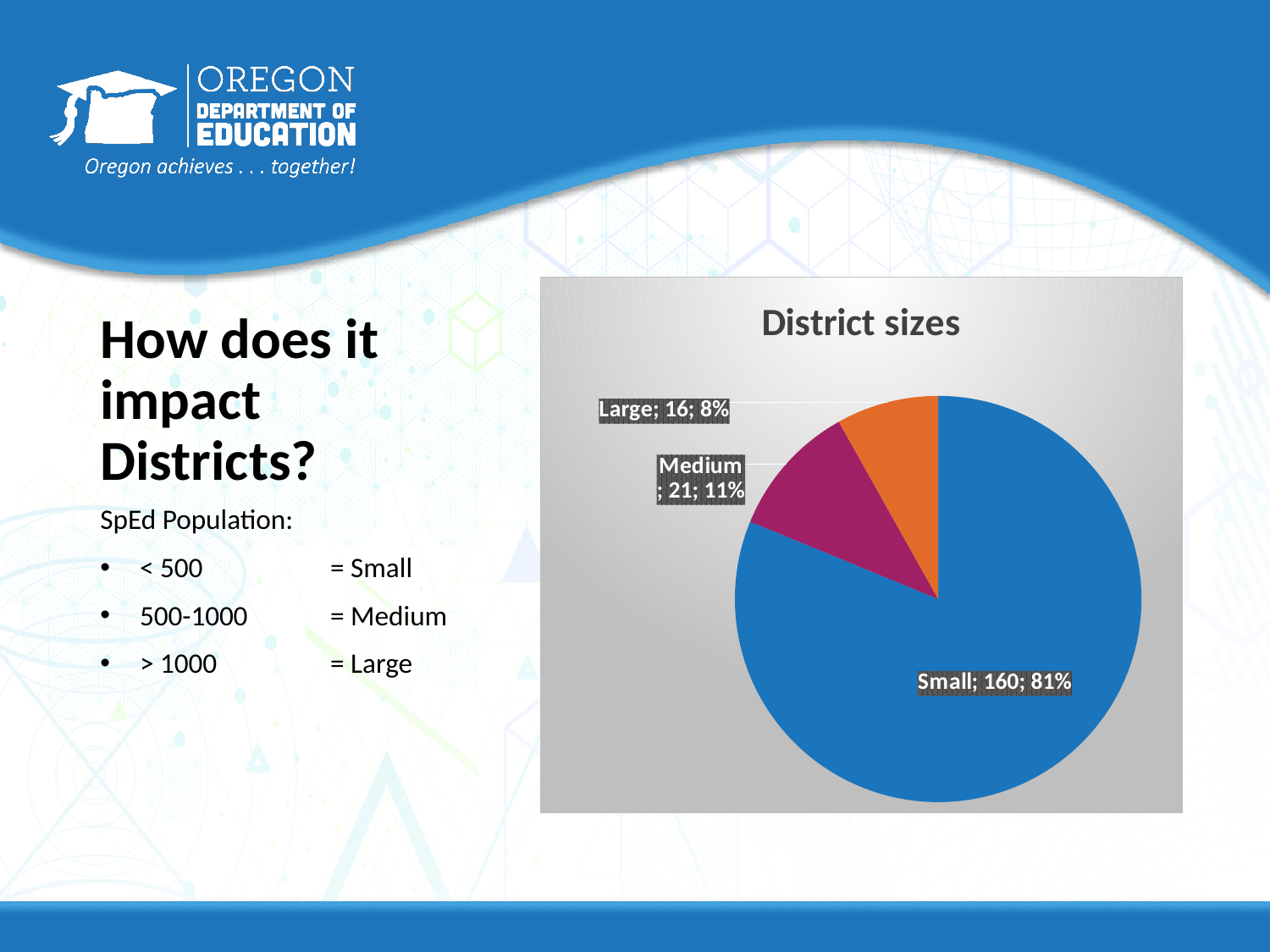
What is the title of the chart? District sizes How many districts are in the Medium category? 21 What is the difference between the number of Small districts and the number of Medium districts? 139 How many districts are in the Small category? 160 What share of the pie does the Small slice represent? 81% What share of the pie does the Large slice represent? 8% What kind of chart is shown on the slide? pie chart What share of the pie does the Medium slice represent? 11% How many districts are in the Large category? 16 Which category has the smallest slice? Large Which category has the largest slice? Small How many slices does the pie chart have? 3